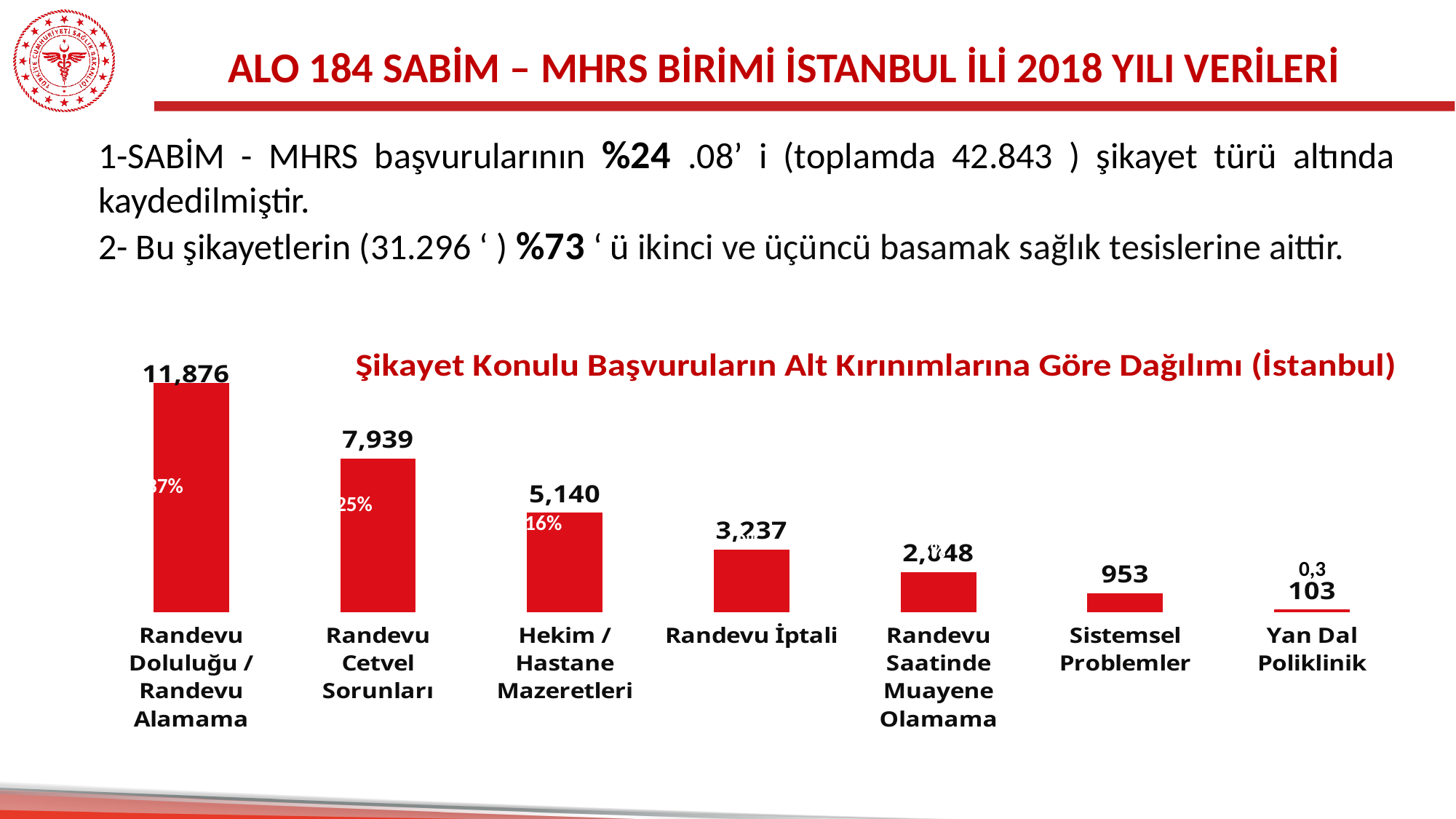
Which category has the highest value? Randevu Doluluğu / Randevu Alamama What is the value for Hekim / Hastane Mazeretleri? 5,140 What kind of chart is shown on the slide? Bar chart Which category has the lowest value? Yan Dal Poliklinik What is the value for Randevu Cetvel Sorunları? 7,939 What is the value for Randevu Doluluğu / Randevu Alamama? 11,876 What is the value for Sistemsel Problemler? 953 What is the value for Yan Dal Poliklinik? 103 Do the values rise or fall from left to right across the categories? Fall Which is larger, the value for Hekim / Hastane Mazeretleri or the value for Sistemsel Problemler? Hekim / Hastane Mazeretleri What is the difference between the values for Randevu Doluluğu / Randevu Alamama and Randevu Cetvel Sorunları? 3,937 How many categories are shown in the chart? 7